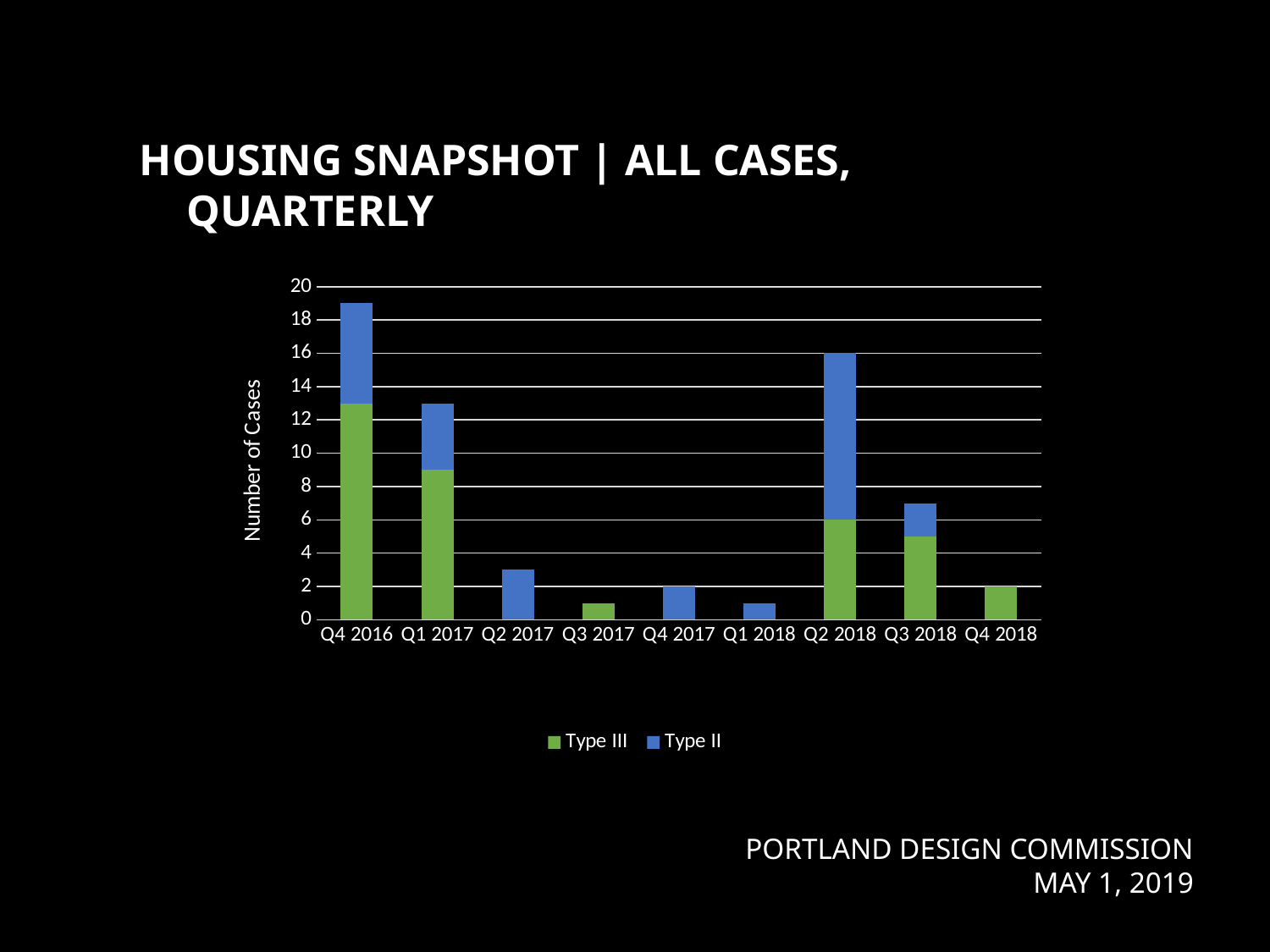
How many series does the chart's legend list? 2 What kind of chart is shown on the slide? Stacked bar chart Which has more total cases, Q1 2017 or Q3 2018? Q1 2017 What is the number of Type III cases in Q2 2018? 6 Which series is shown in green in the chart's legend? Type III What is the total number of cases for Q4 2018? 2 Is the total number of cases for Q4 2016 greater or less than 18? greater Is the total number of cases for Q3 2018 greater or less than 8? less What is the total number of cases for Q2 2018? 16 Which quarter has the highest total number of cases? Q4 2016 What is the label on the vertical axis of the chart? Number of Cases How many quarters are shown on the x axis of the chart? 9